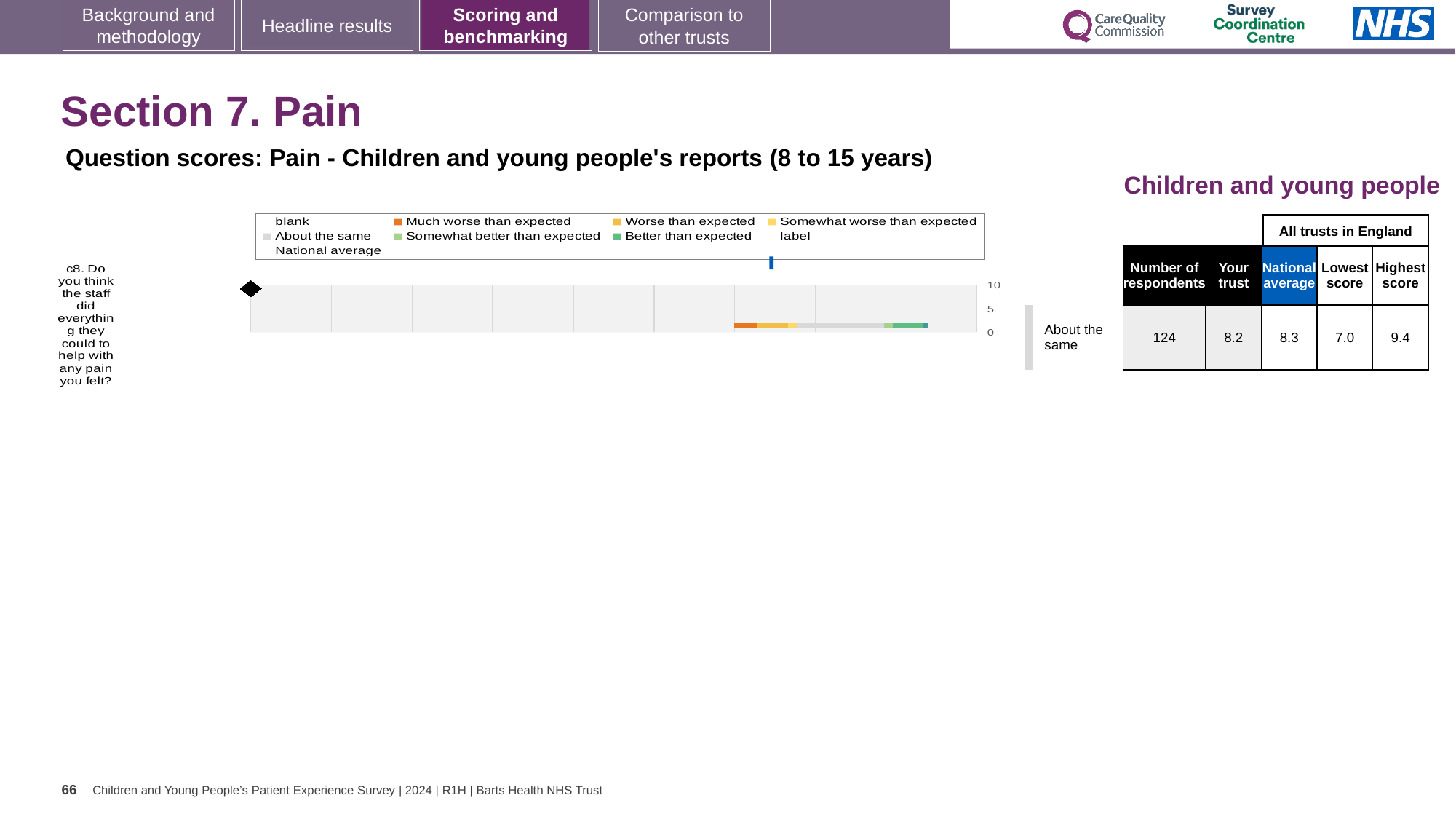
How many entries does the chart legend list? 9 How many respondents answered question c8? 124 What colour represents 'Better than expected' in the chart legend? green What is the 'Your trust' score for question c8 in the table next to the chart? 8.2 What is the lowest score across all trusts in England for question c8? 7.0 Which is larger for question c8: the 'Your trust' score or the national average? National average What colour represents 'Much worse than expected' in the chart legend? orange What is the national average score for question c8 in the table next to the chart? 8.3 What is the highest score across all trusts in England for question c8? 9.4 What is the difference between the highest score and the lowest score for question c8? 2.4 How many survey questions are plotted in the chart? 1 What kind of chart is shown on the slide? bar chart